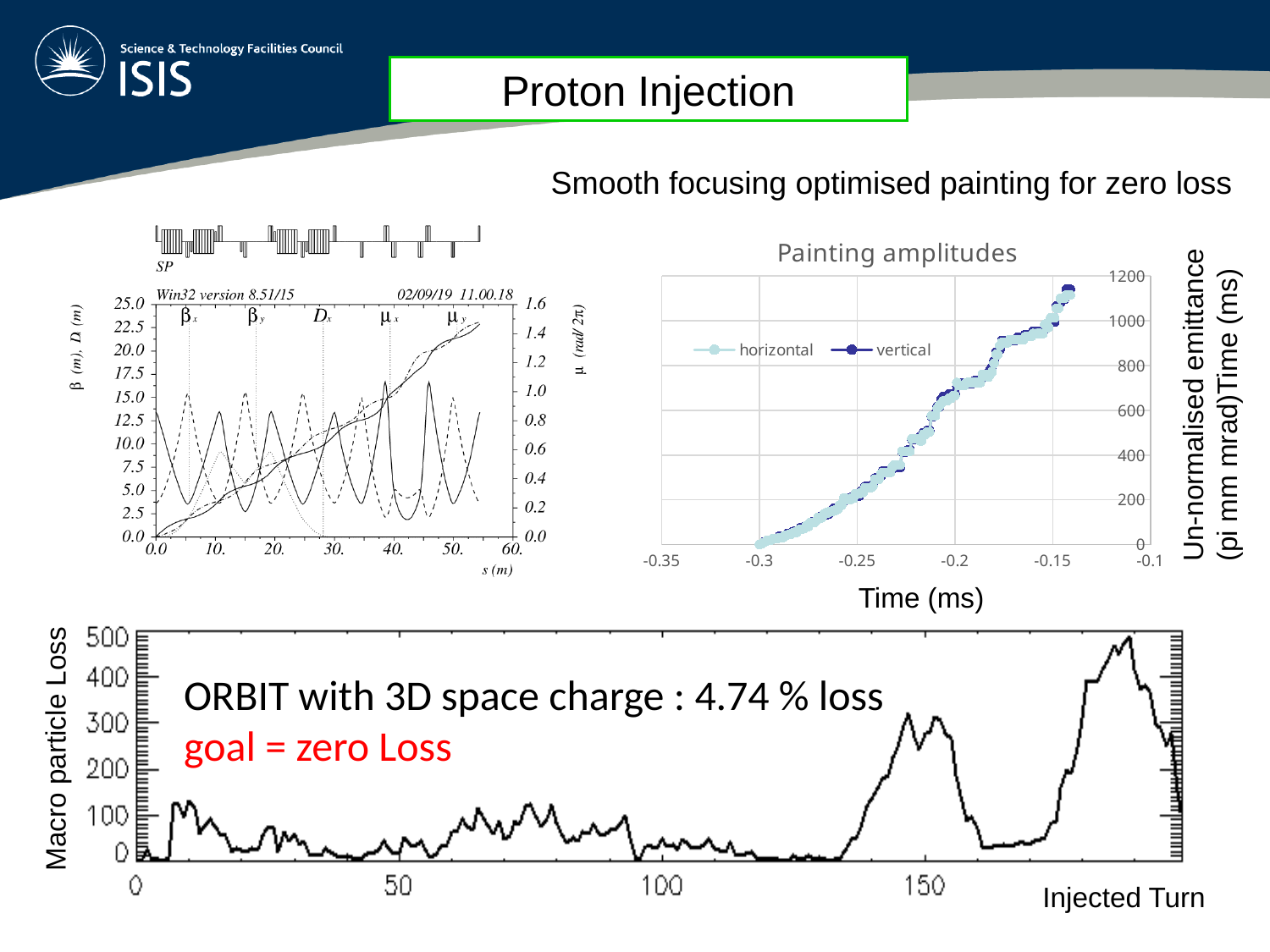
According to the text on the bottom chart, what percentage loss does ORBIT with 3D space charge give? 4.74 % In the Painting amplitudes chart, do the emittance values rise or fall as time increases along the x axis? rise In the Painting amplitudes chart, is the emittance at time -0.2 ms greater or less than 400? greater In the bottom chart, what is the highest tick value on the Macro particle Loss axis? 500 What is the title of the top-right chart? Painting amplitudes In the bottom chart, is the macro particle loss at injected turn 100 greater or less than 100? less In the Painting amplitudes chart, how many series does the legend list? 2 In the Painting amplitudes chart, what are the two series named in the legend? horizontal and vertical In the Painting amplitudes chart, what is the highest value shown on the vertical axis? 1200 What kind of chart is the bottom chart of Macro particle Loss against Injected Turn? line chart In the bottom chart, is the peak macro particle loss near the end of injection greater or less than 400? greater